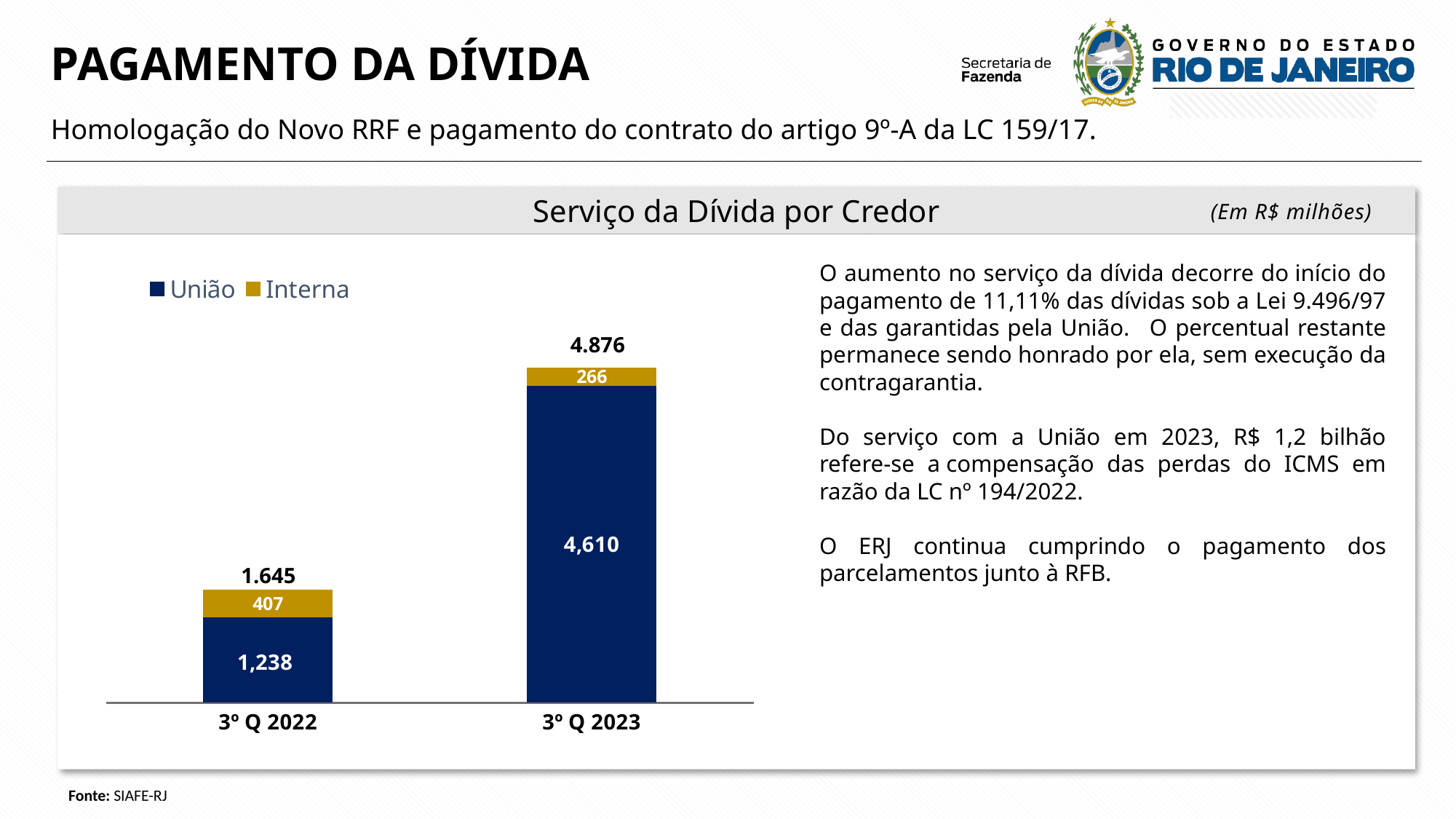
What is the value for Interna in 3º Q 2022? 407 What is the difference between the Interna values for 3º Q 2022 and 3º Q 2023? 141 Which period has the higher value for Interna, 3º Q 2022 or 3º Q 2023? 3º Q 2022 What unit is stated for the chart values? Em R$ milhões What is the total of the stacked bar for 3º Q 2022? 1.645 What is the value for União in 3º Q 2023? 4,610 What kind of chart is shown? Stacked bar chart What is the difference between the União values for 3º Q 2023 and 3º Q 2022? 3,372 How many series does the legend list? 2 What is the total of the stacked bar for 3º Q 2023? 4.876 What is the value for Interna in 3º Q 2023? 266 What is the value for União in 3º Q 2022? 1,238